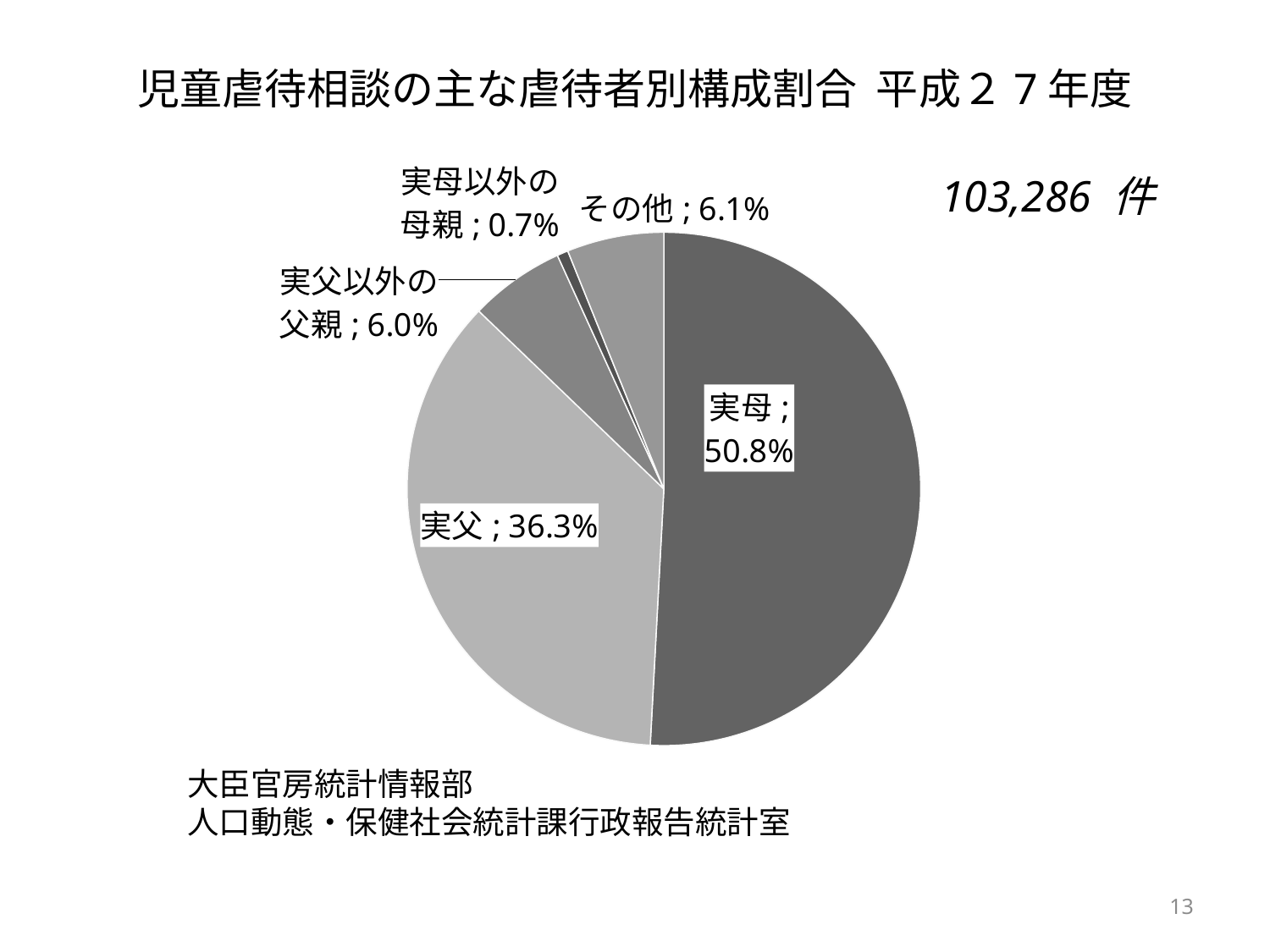
Which is larger, the share for 実父以外の父親 or the share for 実母以外の母親? 実父以外の父親 Which category has the largest share of the pie? 実母 What is the value shown for その他? 6.1% What is the difference in percentage points between 実母 and 実父? 14.5 How many categories (slices) does the pie chart have? 5 What is the value shown for 実父以外の父親? 6.0% What is the value shown for 実母以外の母親? 0.7% What is the value shown for 実父? 36.3% What share of the pie does 実母 account for? 50.8% What kind of chart is shown on the slide? Pie chart Which category has the smallest share of the pie? 実母以外の母親 What total number of cases is shown on the slide next to the chart? 103,286 件